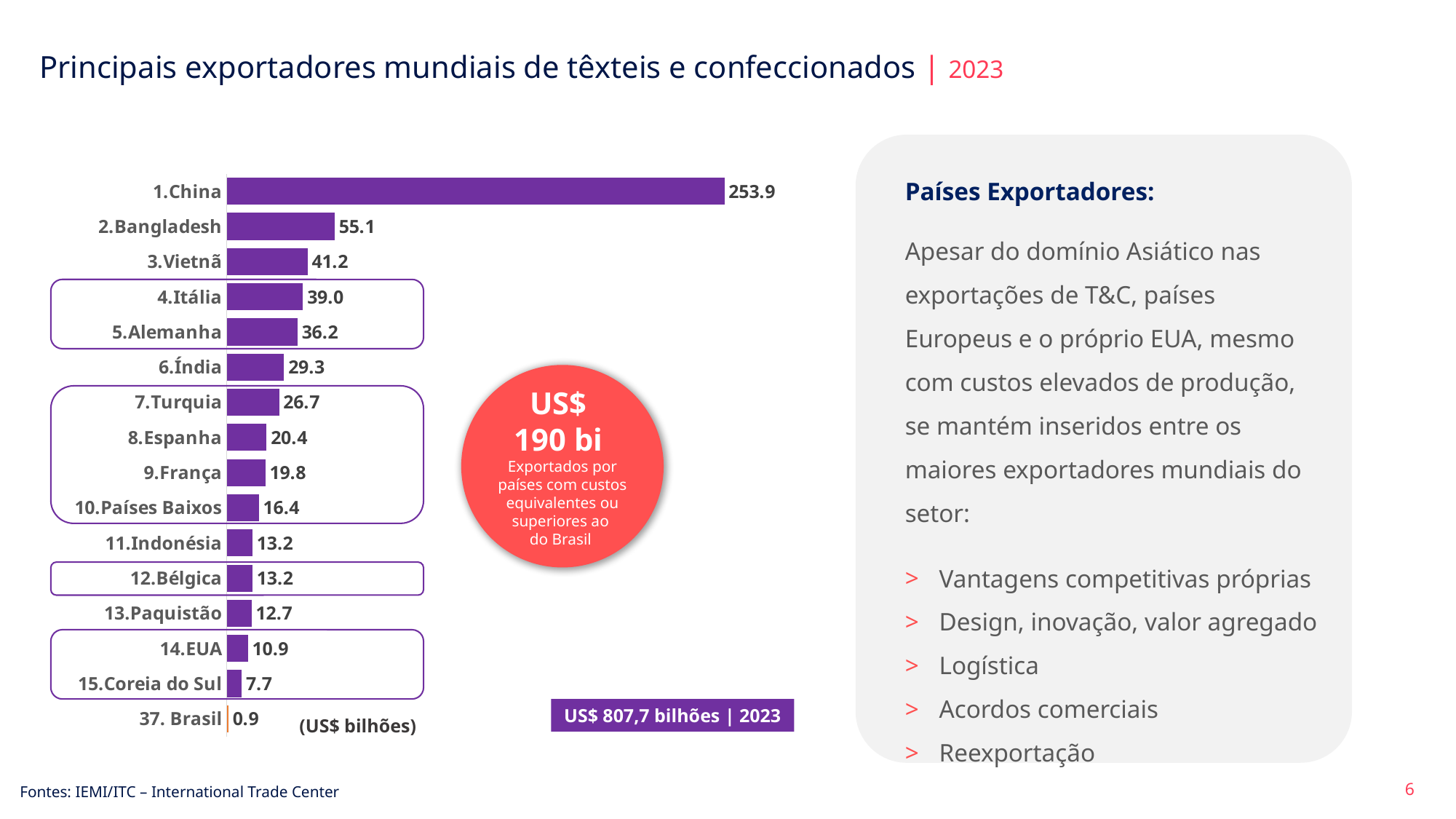
What is the value shown for 14.EUA? 10.9 What is the value shown for 2.Bangladesh? 55.1 Which has a larger value, 4.Itália or 5.Alemanha? 4.Itália What is the difference between the values for China and Bangladesh? 198.8 Which country has the lowest value in the chart? Brasil What type of chart is shown on the slide? bar chart What is the value shown for 37. Brasil? 0.9 What unit is indicated for the values in the bar chart? US$ bilhões How many countries are plotted in the bar chart? 16 Which country has the highest value in the chart? China Do the values rise or fall going from the top bar to the bottom bar? fall What is the value shown for 6.Índia? 29.3